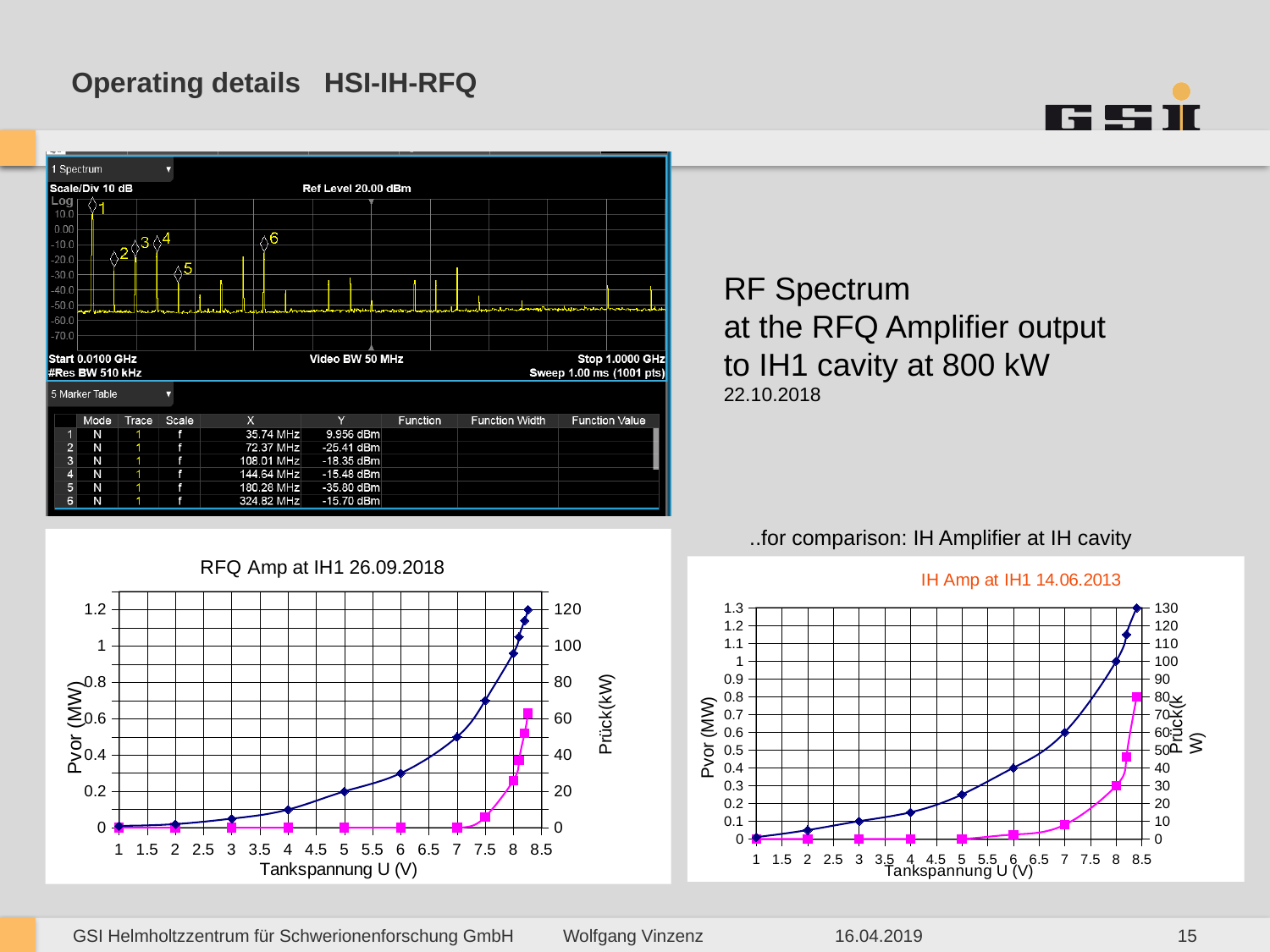
In the RF spectrum marker table at the top left, what is the Y value of marker 1? 9.956 dBm In the chart 'RFQ Amp at IH1 26.09.2018', does Pvor rise or fall as Tankspannung U increases? rise In the chart 'RFQ Amp at IH1 26.09.2018', which is larger: Pvor at U = 7 V or Pvor at U = 6 V? Pvor at U = 7 V In the chart 'IH Amp at IH1 14.06.2013', is the Pvor value at U = 7 V greater or less than 0.5 MW? greater In the chart 'RFQ Amp at IH1 26.09.2018', is the Prück value at U = 7.5 V greater or less than 20 kW? less In the chart 'RFQ Amp at IH1 26.09.2018', is the Pvor value at U = 6 V greater or less than 0.4 MW? less What is the x-axis title of the chart 'IH Amp at IH1 14.06.2013'? Tankspannung U (V) What kind of chart is 'RFQ Amp at IH1 26.09.2018'? line chart